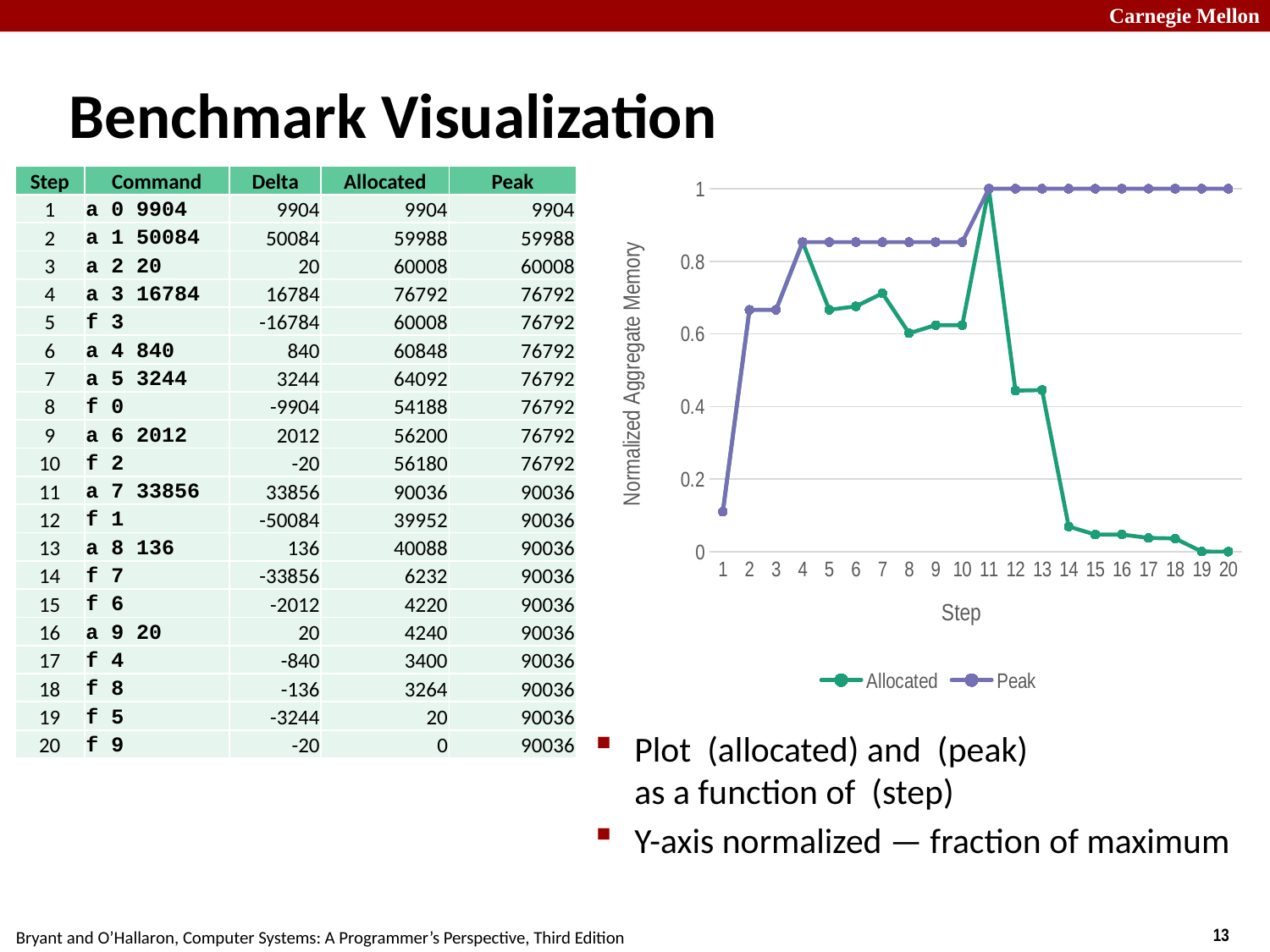
What is the title of the chart's y axis? Normalized Aggregate Memory How many steps are plotted along the x axis of the chart? 20 Is the Allocated value at step 4 greater or less than 0.8? greater How many series does the chart's legend list? 2 Is the Allocated value at step 12 greater or less than 0.6? less Is the Allocated value at step 1 greater or less than 0.2? less What is the Peak value at step 20 in the chart? 1 What is the Allocated value at step 20 in the chart? 0 At which step does the Allocated series reach its highest value? 11 At step 12, which series has the larger value, Allocated or Peak? Peak Does the Allocated series rise or fall from step 13 to step 20? fall What kind of chart is shown on the slide? line chart